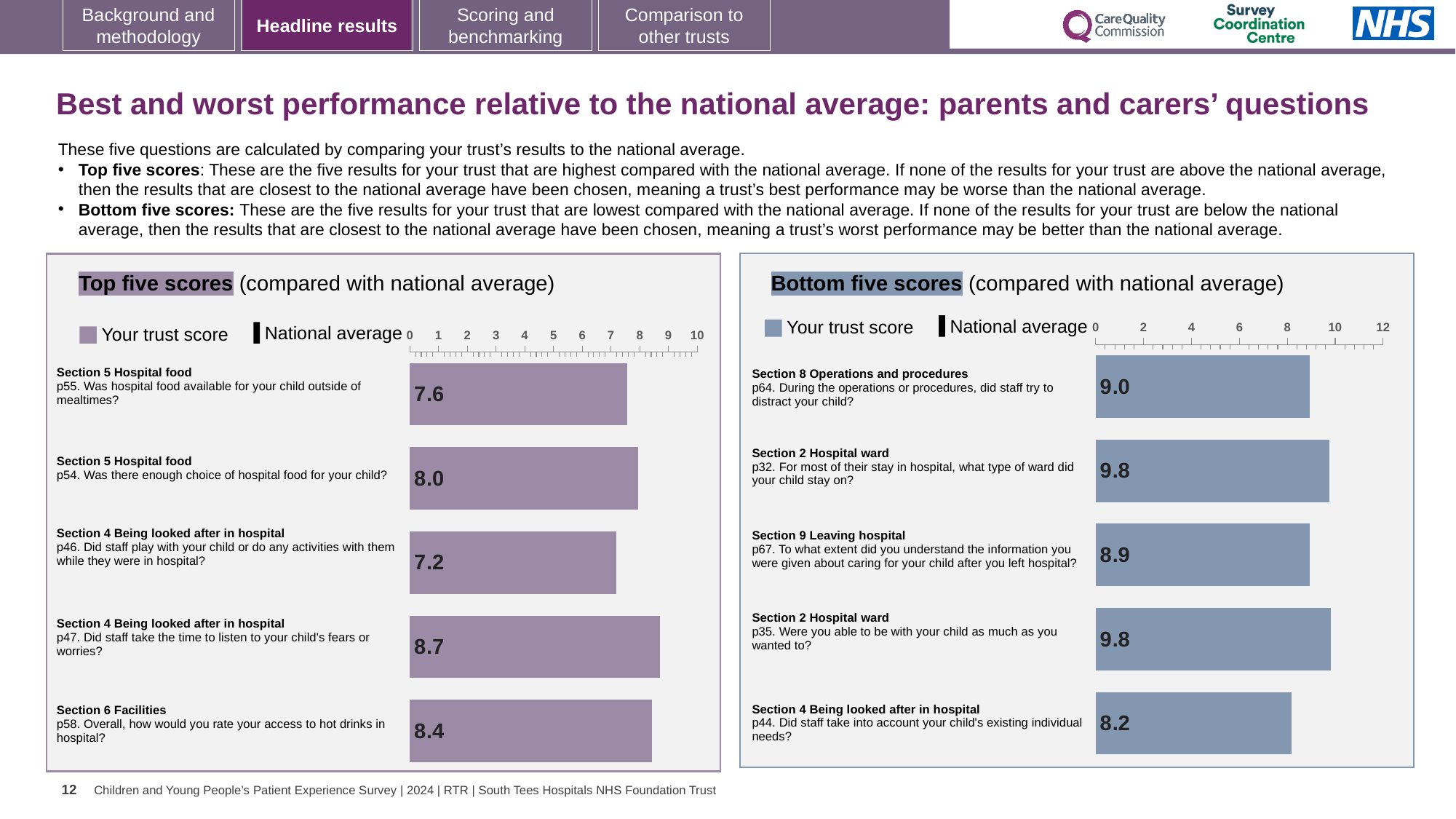
In the 'Top five scores' chart, what is the difference between the trust scores for p54 and p46? 0.8 In the 'Bottom five scores' chart, what is the difference between the trust scores for p35 and p44? 1.6 In the 'Top five scores' chart, which question has the highest trust score? p47. Did staff take the time to listen to your child's fears or worries? In the 'Top five scores' chart, which question has the lowest trust score? p46. Did staff play with your child or do any activities with them while they were in hospital? In the 'Top five scores' chart, what is the trust score for p47 (Did staff take the time to listen to your child's fears or worries?)? 8.7 In the 'Bottom five scores' chart, which question has the lowest trust score? p44. Did staff take into account your child's existing individual needs? In the 'Bottom five scores' chart, is the trust score for p67 larger or smaller than the trust score for p32? smaller In the 'Bottom five scores' chart, what is the trust score for p64 (During the operations or procedures, did staff try to distract your child?)? 9.0 What type of chart is used in the 'Top five scores' panel? bar chart In the 'Top five scores' chart, what is the trust score for p55 (Was hospital food available for your child outside of mealtimes?)? 7.6 In the 'Top five scores' chart, how many questions are plotted? 5 In the 'Bottom five scores' chart, what is the trust score for p44 (Did staff take into account your child's existing individual needs?)? 8.2